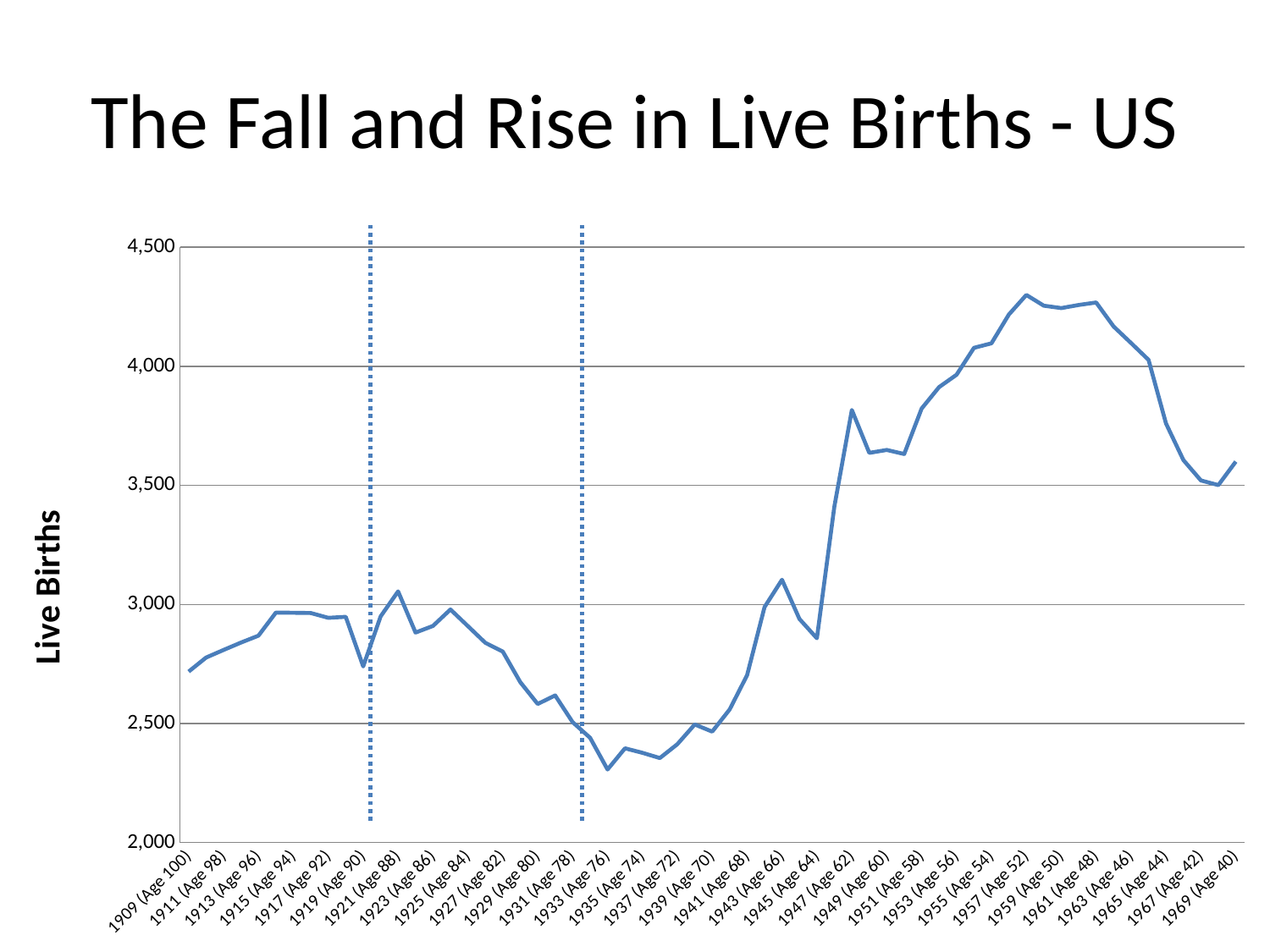
Do live births rise or fall between 1933 (Age 76) and 1957 (Age 52)? rise Is the value for 1947 (Age 62) greater or less than 3,500? greater Is the value for 1965 (Age 44) greater or less than 4,000? less Is the value for 1933 (Age 76) greater or less than 2,500? less What is the title of the slide's chart? The Fall and Rise in Live Births - US Do live births rise or fall between 1961 (Age 48) and 1967 (Age 42)? fall What kind of chart is shown on the slide? line chart Which labelled year has the lowest number of live births? 1933 (Age 76) What is the label on the vertical axis? Live Births Which is larger, the value for 1947 (Age 62) or the value for 1909 (Age 100)? 1947 (Age 62)